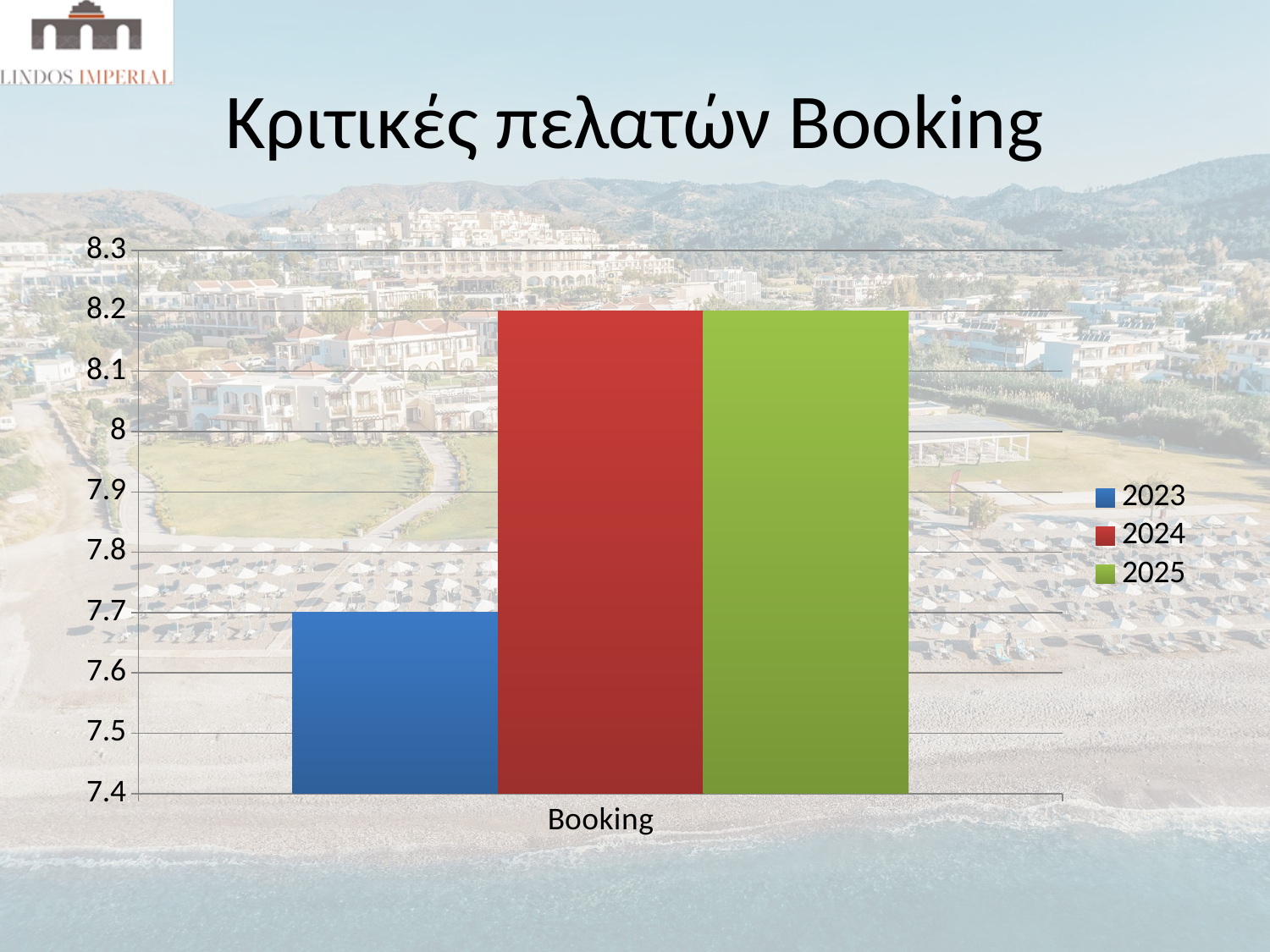
What is the value for 2024 in the Booking chart? 8.2 How many categories are shown on the x axis of the chart? 1 How many series does the legend list? 3 Is the value for 2025 greater or less than 8? greater Which is larger, the value for 2023 or the value for 2024? 2024 What is the difference between the values for 2024 and 2023? 0.5 What is the value for 2025 in the Booking chart? 8.2 Which year has the lowest value in the chart? 2023 Is the value for 2023 greater or less than 8? less What is the value for 2023 in the Booking chart? 7.7 What is the title of the slide above the chart? Κριτικές πελατών Booking What kind of chart is shown on the slide? bar chart